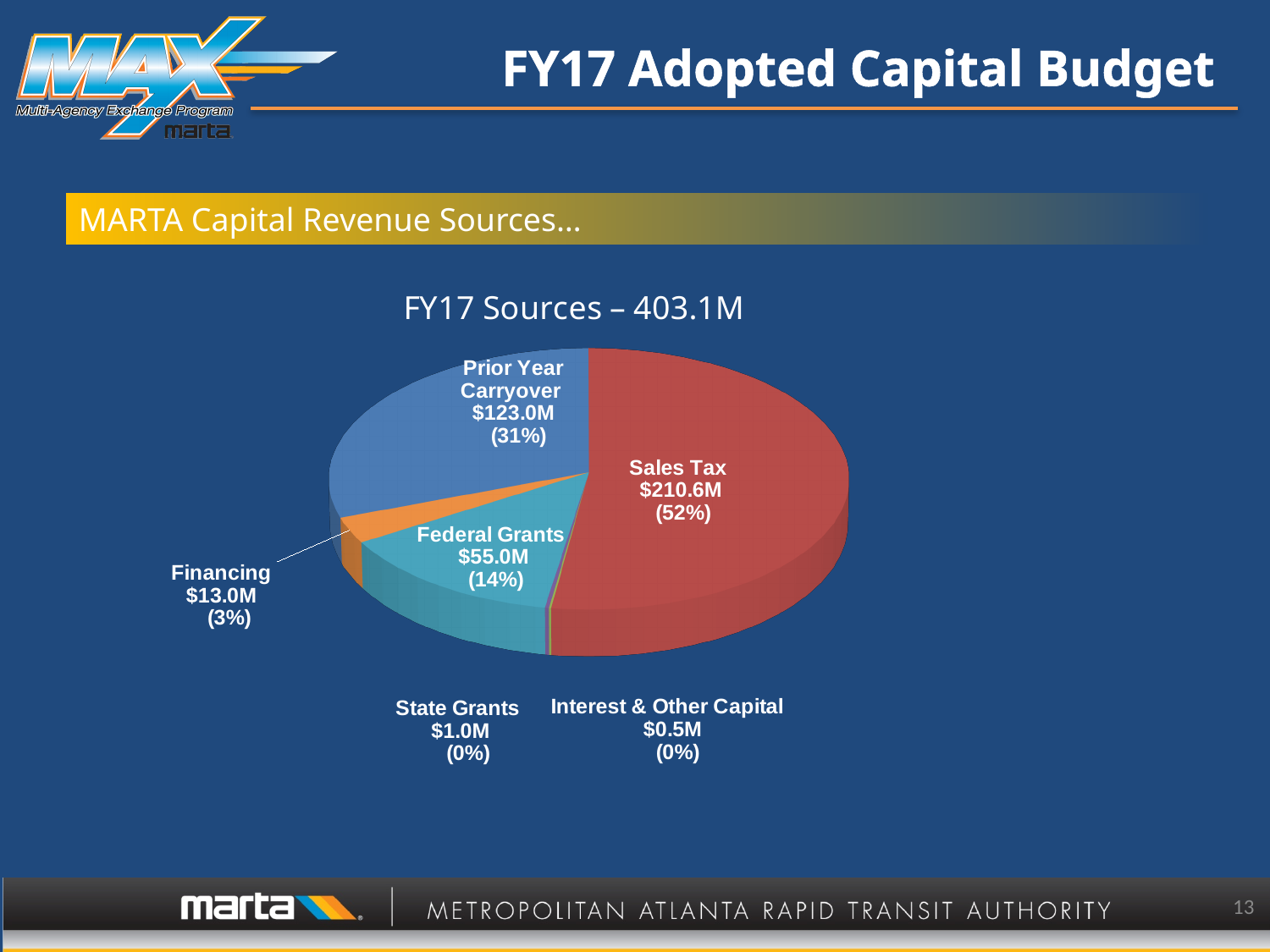
What is the value for Federal Grants? $55.0M What share of the pie does Federal Grants represent? 14% What is the value for Financing? $13.0M What is the value for Sales Tax? $210.6M Which is larger, Federal Grants or Financing? Federal Grants What type of chart is shown on the slide? Pie chart Which source is the largest slice of the pie? Sales Tax Which source is the smallest slice of the pie? Interest & Other Capital How many sources are shown in the pie chart? 6 What share of the pie does Prior Year Carryover represent? 31% What is the difference between Sales Tax and Prior Year Carryover? $87.6M What is the value for Prior Year Carryover? $123.0M